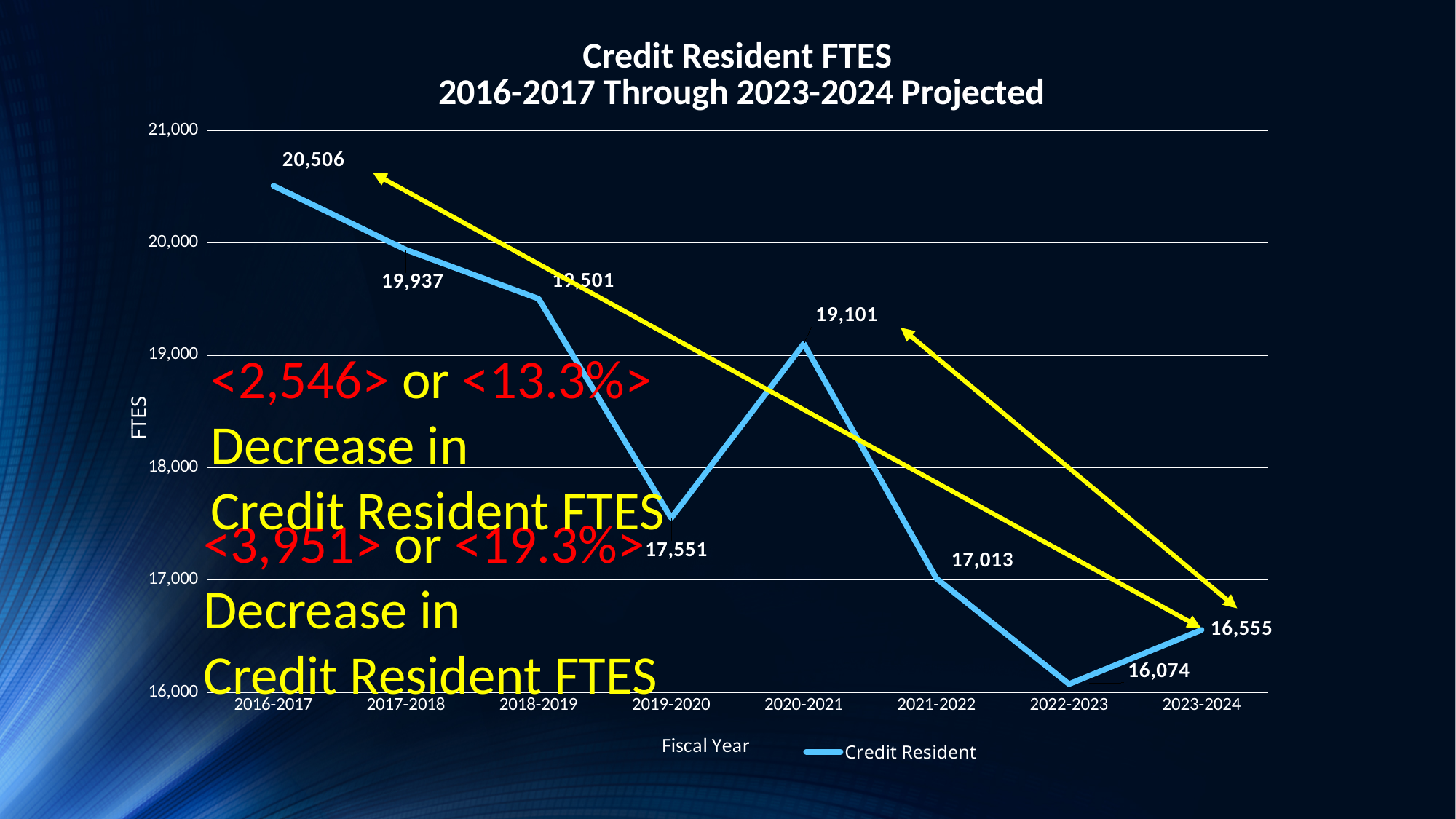
Which fiscal year has the lowest Credit Resident FTES? 2022-2023 What is the Credit Resident FTES value for 2020-2021? 19,101 What is the difference in Credit Resident FTES between 2016-2017 and 2017-2018? 569 What kind of chart is shown on the slide? Line chart What is the Credit Resident FTES value for 2016-2017? 20,506 What is the difference in Credit Resident FTES between 2021-2022 and 2022-2023? 939 What series name does the legend show? Credit Resident How many fiscal years are plotted on the x axis? 8 Which fiscal year has a higher Credit Resident FTES, 2019-2020 or 2020-2021? 2020-2021 Which fiscal year has the highest Credit Resident FTES? 2016-2017 What is the Credit Resident FTES value for 2022-2023? 16,074 What is the projected Credit Resident FTES value for 2023-2024? 16,555